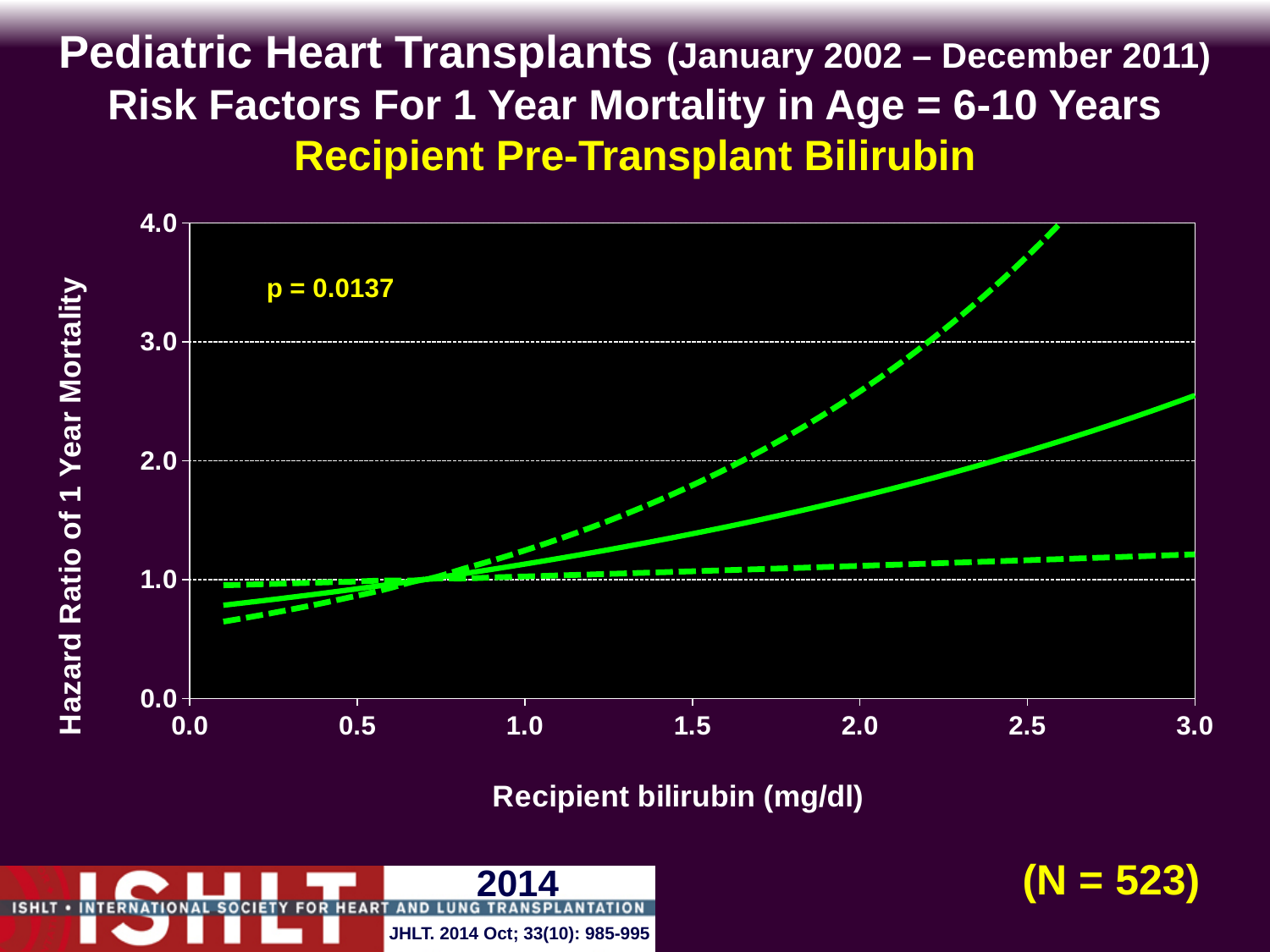
What kind of chart is shown on the slide? line chart What is the highest value shown on the y axis of the chart? 4.0 Is the value of the solid hazard ratio line at a recipient bilirubin of 3.0 mg/dl greater or less than 2.0? greater Is the value of the lower dashed line at a recipient bilirubin of 3.0 mg/dl greater or less than 2.0? less Is the value of the upper dashed line at a recipient bilirubin of 2.5 mg/dl greater or less than 3.0? greater Does the solid hazard ratio line rise or fall as recipient bilirubin increases along the x axis? rise How many lines are plotted on the chart? 3 What p-value is printed on the chart? p = 0.0137